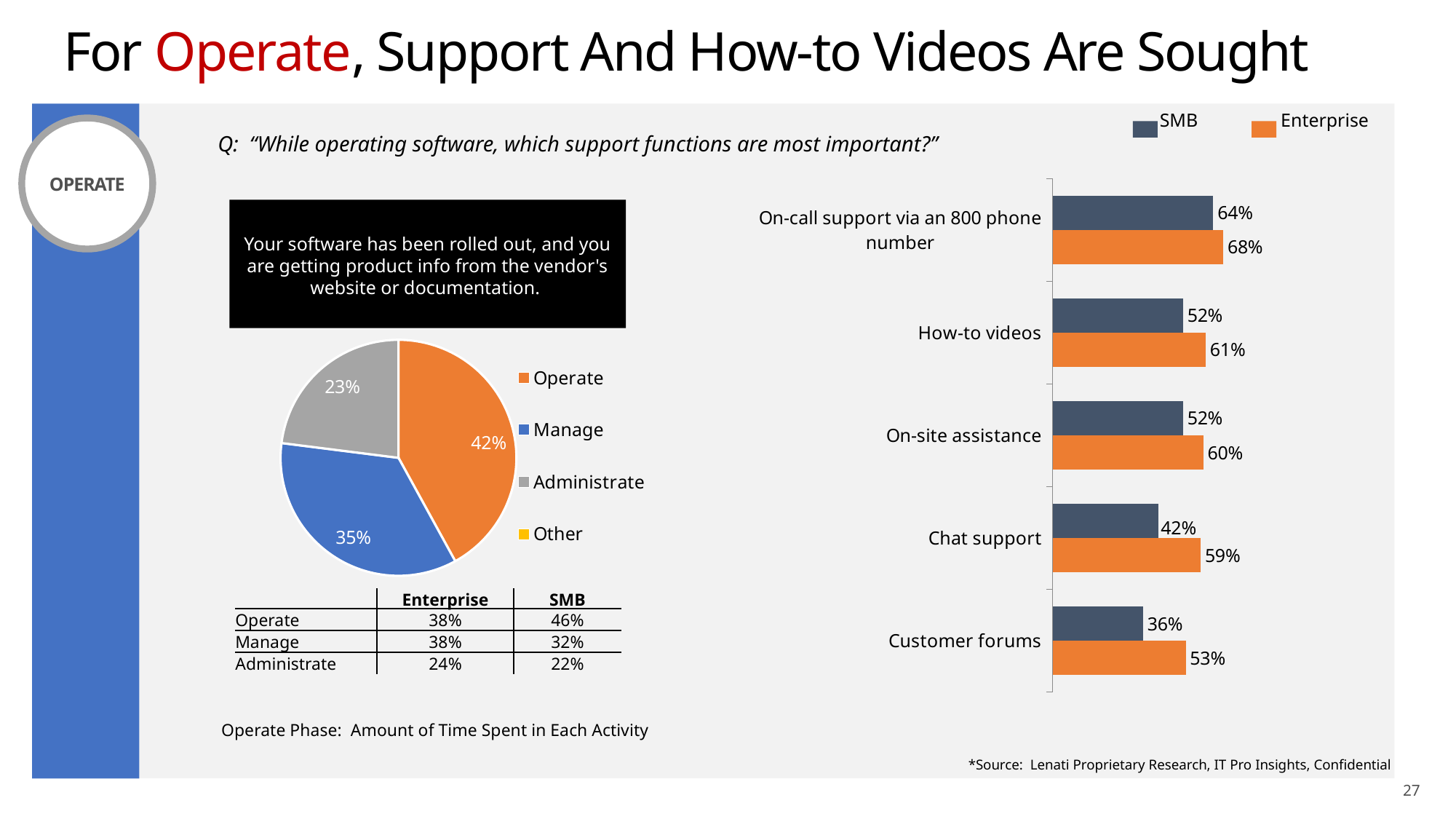
What kind of chart is the chart on the right side of the slide? bar chart In the pie chart on the left, what colour is the Manage slice? blue How many support functions are shown in the bar chart on the right? 5 In the bar chart on the right, which support function has the lowest Enterprise value? Customer forums In the pie chart on the left, what share does Operate have? 42% In the bar chart on the right, what is the SMB value for Customer forums? 36% How many series does the legend of the bar chart on the right list? 2 In the bar chart on the right, what is the difference between the Enterprise and SMB values for Chat support? 17% In the bar chart on the right, is the SMB value for On-site assistance larger or smaller than the Enterprise value for On-site assistance? smaller In the bar chart on the right, what is the Enterprise value for How-to videos? 61% In the pie chart on the left, which activity has the smallest labelled slice? Administrate In the bar chart on the right, which support function has the highest SMB value? On-call support via an 800 phone number